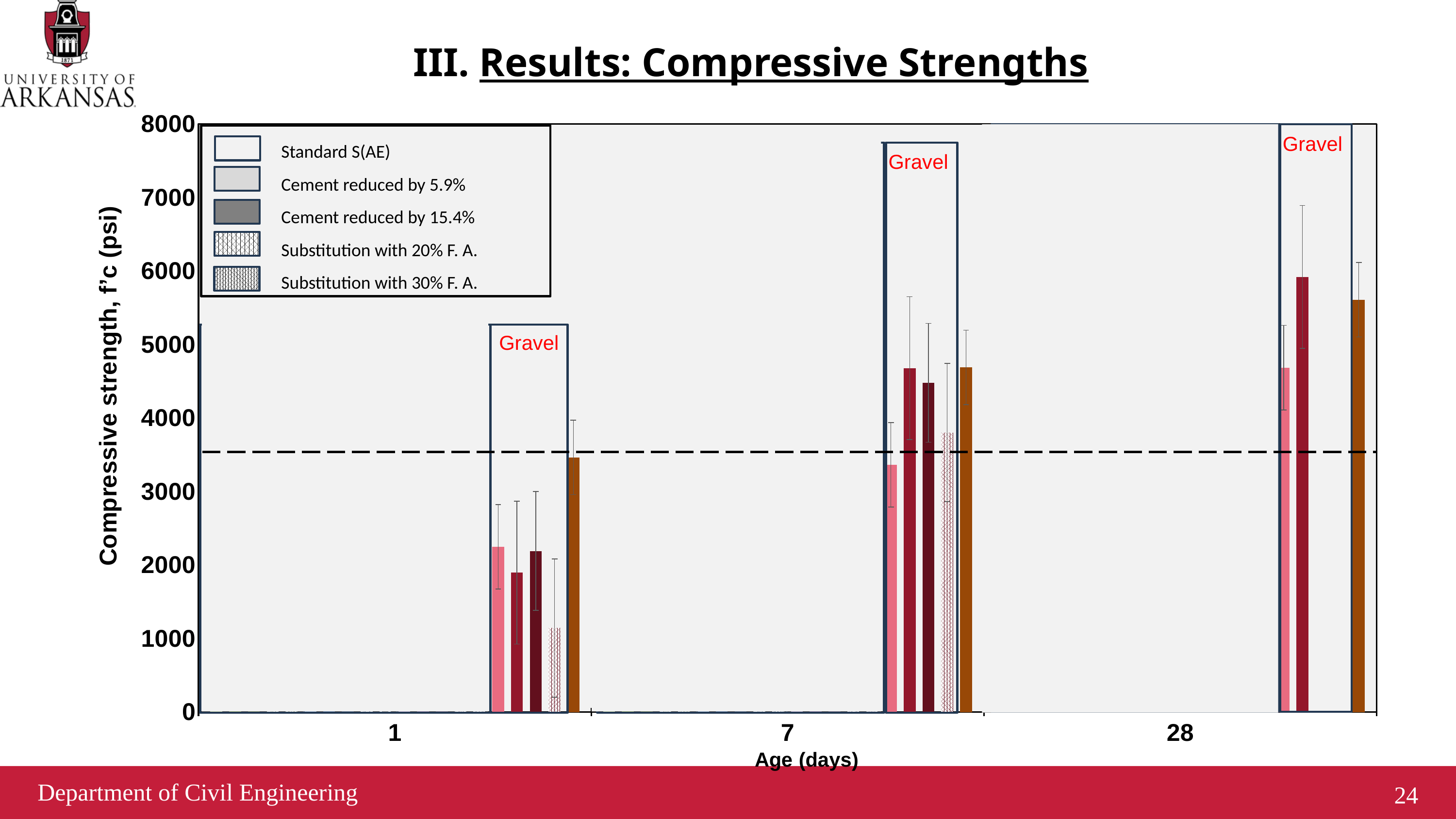
At 28 days, is the value of the red (second) bar greater or less than 5000? greater What kind of chart is shown on the slide? bar chart At 1 day, which bar in the group is the tallest? the brown (rightmost) bar At 1 day, is the value of the hatched bar greater or less than 2000? less What is the label of the y axis? Compressive strength, f'c (psi) What red label appears above each group of bars? Gravel At 7 days, which is taller: the pink (leftmost) bar or the brown (rightmost) bar? the brown bar At 7 days, is the value of the pink (leftmost) bar greater or less than 4000? less How many age categories are shown on the x axis? 3 Do the values of the brown bars rise or fall as age increases from 1 to 28 days? rise How many series does the legend list? 5